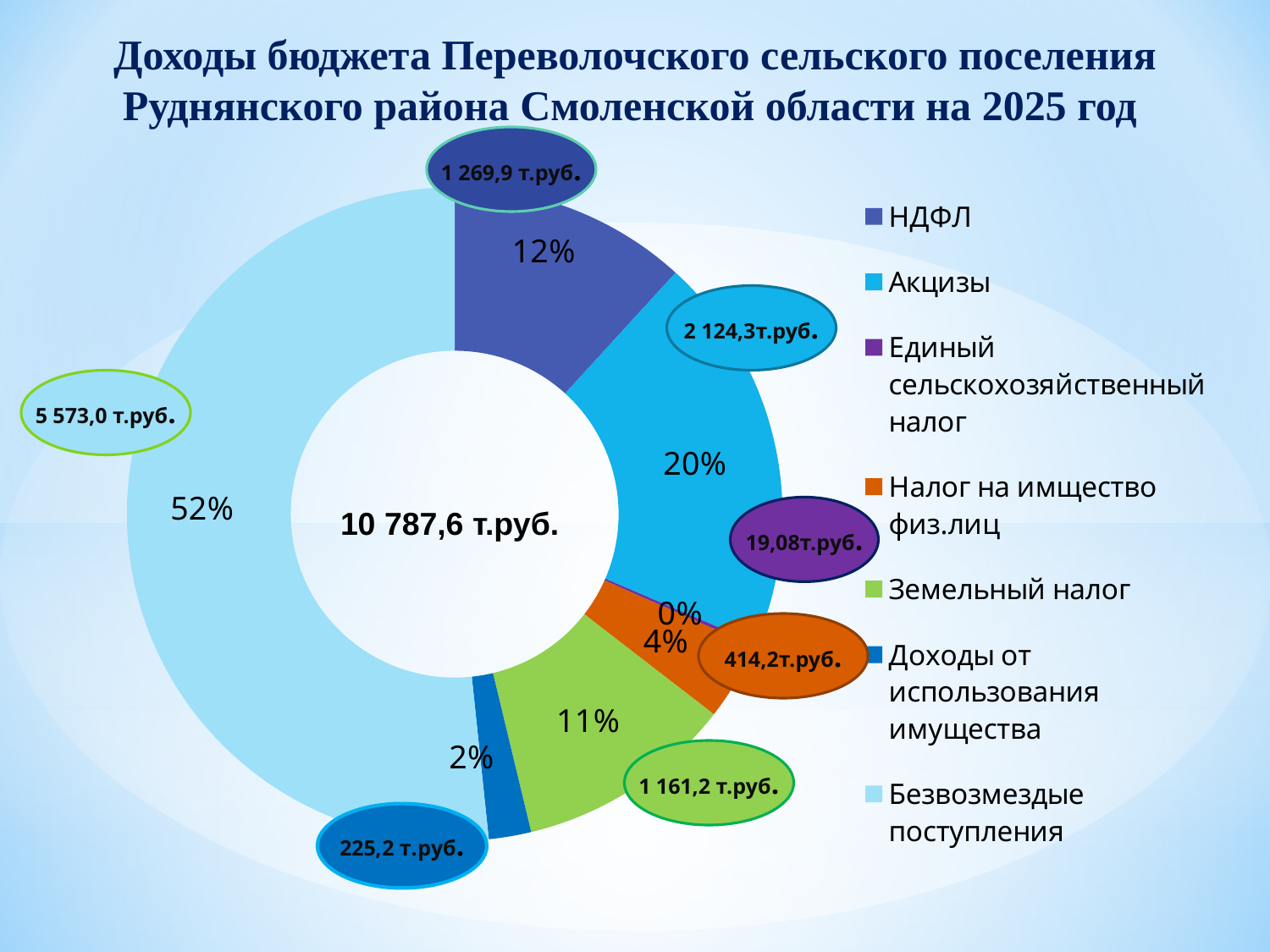
What is the value shown for Земельный налог? 1 161,2 т.руб. What kind of chart is shown on the slide? Doughnut (pie) chart What is the value shown for Налог на имущество физ.лиц? 414,2т.руб. Which category has the smallest share of the budget revenue? Единый сельскохозяйственный налог What total value is shown in the centre of the chart? 10 787,6 т.руб. What share of the budget revenue is Акцизы? 20% How many categories does the legend list? 7 Which category has the largest share of the budget revenue? Безвозмездные поступления Which is larger: the share for Акцизы or the share for Земельный налог? Акцизы What share of the budget revenue is Безвозмездные поступления? 52% What is the value shown for Единый сельскохозяйственный налог? 19,08т.руб. What share of the budget revenue is НДФЛ? 12%